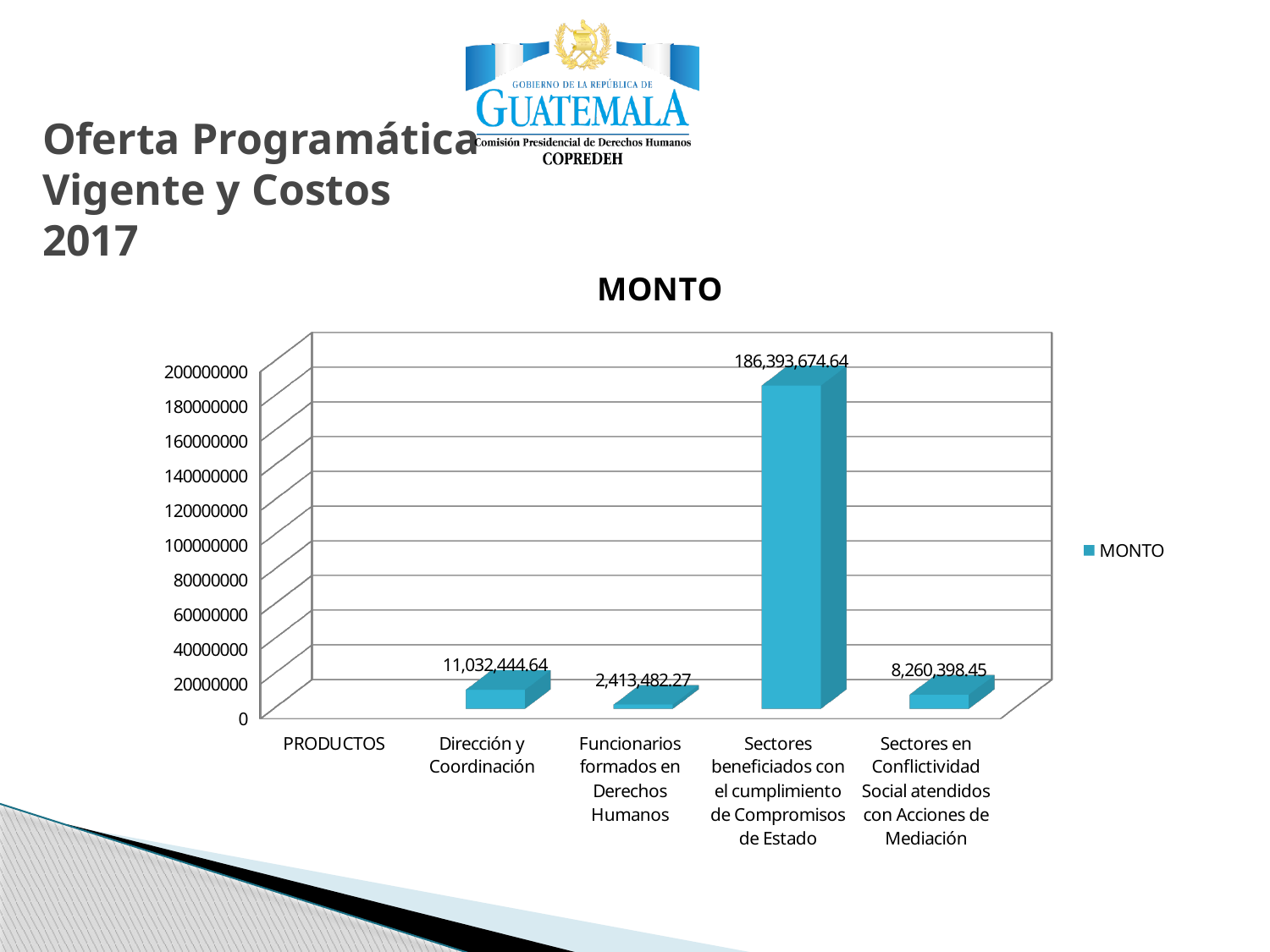
What kind of chart is shown on the slide? bar chart Which is larger, the value for Dirección y Coordinación or the value for Sectores en Conflictividad Social atendidos con Acciones de Mediación? Dirección y Coordinación How many series does the legend list? 1 Is the value for Sectores beneficiados con el cumplimiento de Compromisos de Estado greater or less than 180000000? greater What is the value for Funcionarios formados en Derechos Humanos? 2,413,482.27 What is the value for Dirección y Coordinación? 11,032,444.64 How many bars are plotted in the chart? 4 What is the difference between the values for Dirección y Coordinación and Sectores en Conflictividad Social atendidos con Acciones de Mediación? 2,772,046.19 Which category has the lowest plotted value? Funcionarios formados en Derechos Humanos Which category has the highest value? Sectores beneficiados con el cumplimiento de Compromisos de Estado What is the value for Sectores en Conflictividad Social atendidos con Acciones de Mediación? 8,260,398.45 What is the value for Sectores beneficiados con el cumplimiento de Compromisos de Estado? 186,393,674.64